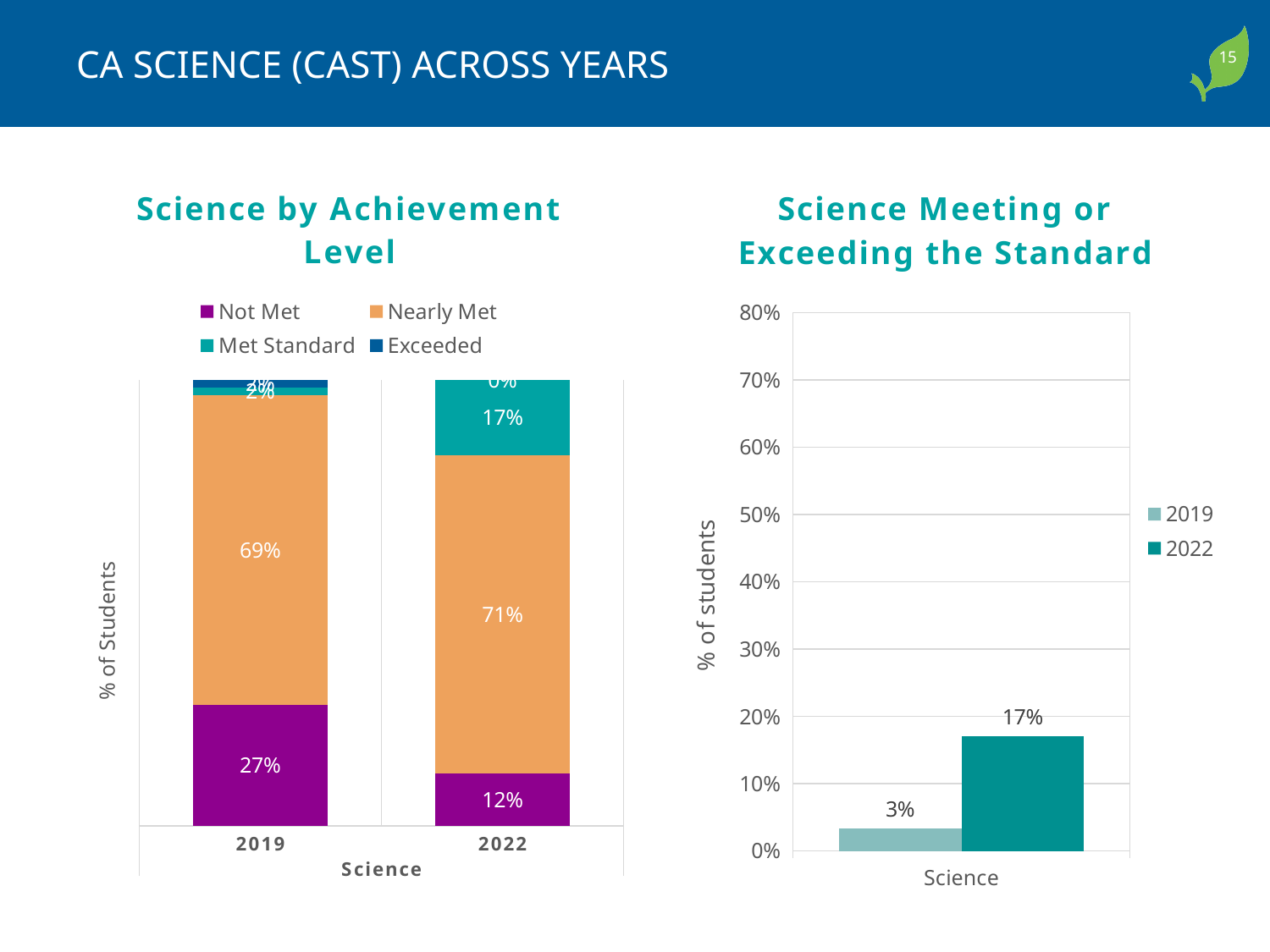
In the 'Science Meeting or Exceeding the Standard' chart, what is the value for 2022? 17% What kind of chart is the 'Science Meeting or Exceeding the Standard' chart? bar chart How many years (categories) are shown on the x axis of the 'Science by Achievement Level' chart? 2 How many series does the legend of the 'Science by Achievement Level' chart list? 4 In the 'Science by Achievement Level' chart, what is the difference between the Not Met values for 2019 and 2022? 15% In the 'Science Meeting or Exceeding the Standard' chart, which year has the larger value, 2019 or 2022? 2022 In the 'Science by Achievement Level' chart, what percentage of students were in the Nearly Met level in 2022? 71% In the 'Science Meeting or Exceeding the Standard' chart, what is the value for 2019? 3% In the 'Science by Achievement Level' chart, what percentage of students were in the Met Standard level in 2022? 17% How many series does the legend of the 'Science Meeting or Exceeding the Standard' chart list? 2 In the 'Science Meeting or Exceeding the Standard' chart, what is the difference between the 2022 and 2019 values? 14% In the 'Science by Achievement Level' chart, what percentage of students were in the Not Met level in 2019? 27%